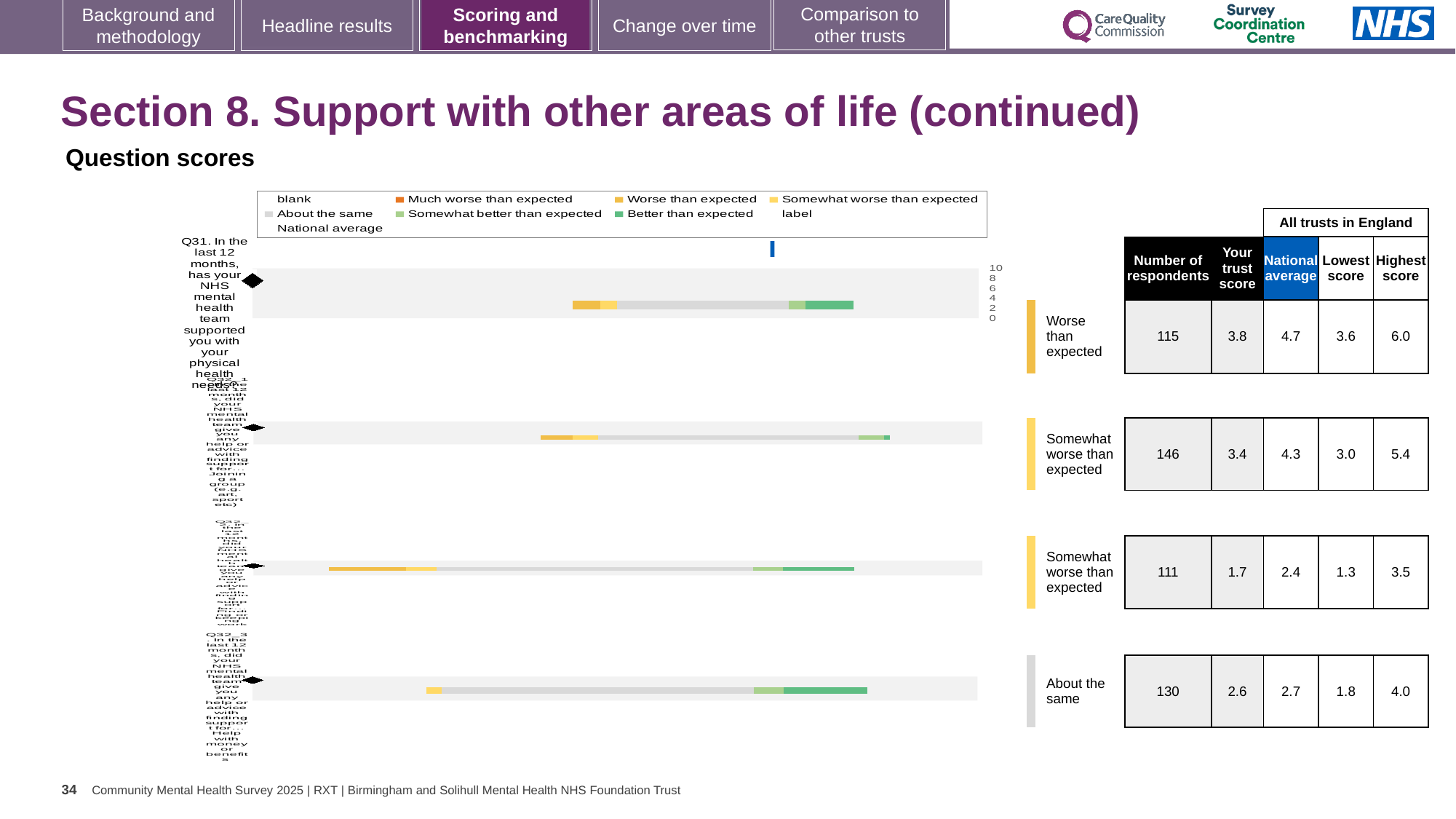
What is the heading above the chart? Question scores What is the national average for Q31 (the first row)? 4.7 How many respondents are shown for Q31 (the first row)? 115 What is the lowest 'Your trust score' shown in the table? 1.7 Which is larger for Q31: your trust score or the national average? national average What is the highest number of respondents shown in the table? 146 What kind of chart is shown on the slide? bar chart What is 'Your trust score' for the row rated 'About the same' (the last row)? 2.6 How many question rows (bars) does the chart show? 4 What colour does the legend use for 'About the same'? grey What is 'Your trust score' for Q31 (the first row)? 3.8 What is the difference between the national average and your trust score for Q31? 0.9